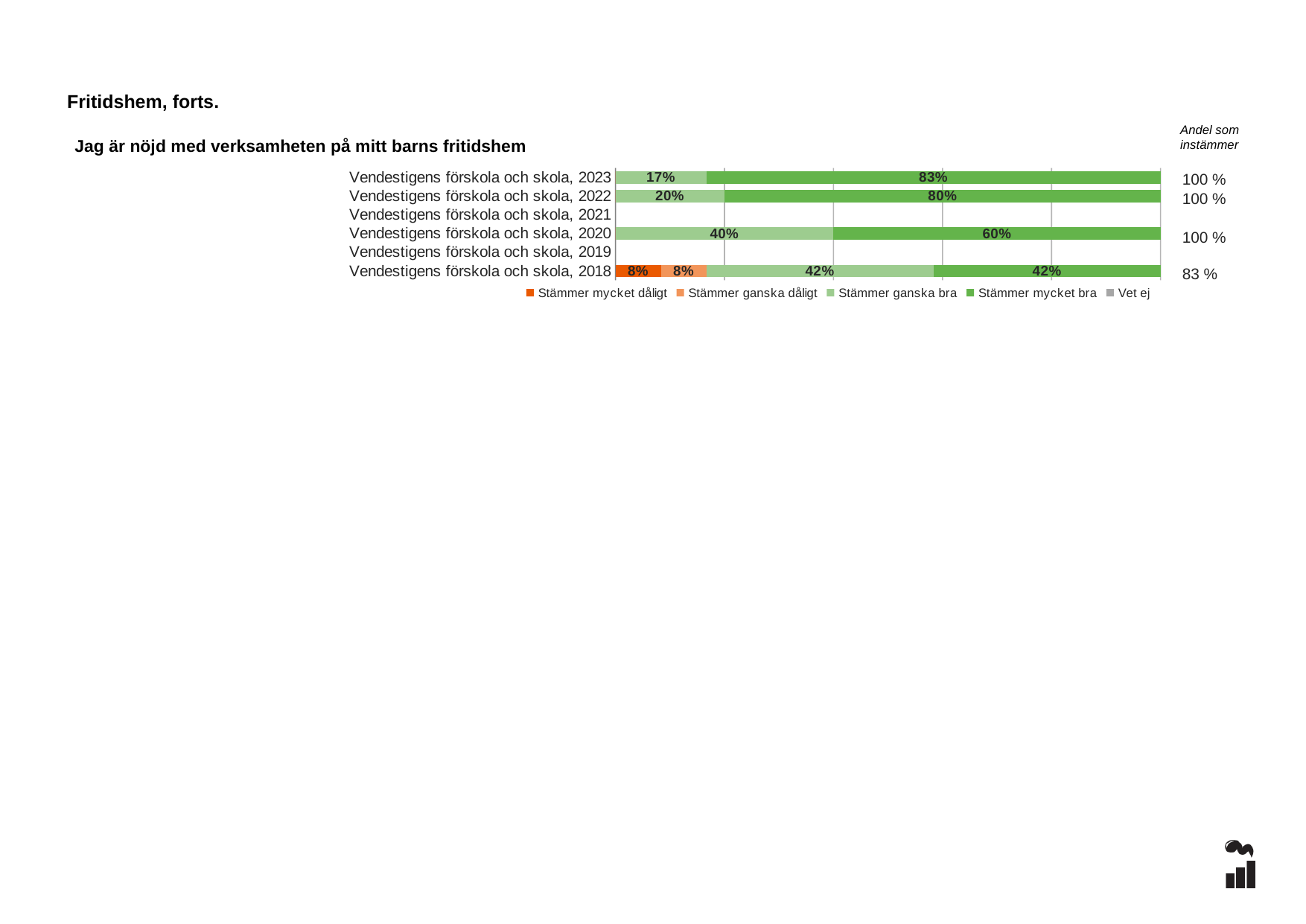
Which year has the lowest "Stämmer mycket bra" share among the years with data? Vendestigens förskola och skola, 2018 What percentage of respondents answered "Stämmer ganska bra" for Vendestigens förskola och skola, 2020? 40% What is the difference between the "Stämmer mycket bra" share in 2023 and in 2022? 3% How many series does the legend list? 5 How many category rows are shown on the y axis of the chart? 6 What percentage of respondents answered "Stämmer mycket bra" for Vendestigens förskola och skola, 2023? 83% What percentage of respondents answered "Stämmer mycket dåligt" for Vendestigens förskola och skola, 2018? 8% What is the title of the chart? Jag är nöjd med verksamheten på mitt barns fritidshem What kind of chart is shown on the slide? Stacked bar chart Which year has the highest "Stämmer mycket bra" share? Vendestigens förskola och skola, 2023 Is the "Stämmer ganska bra" share larger in 2020 or in 2022? 2020 What is the "Andel som instämmer" value shown for Vendestigens förskola och skola, 2018? 83 %